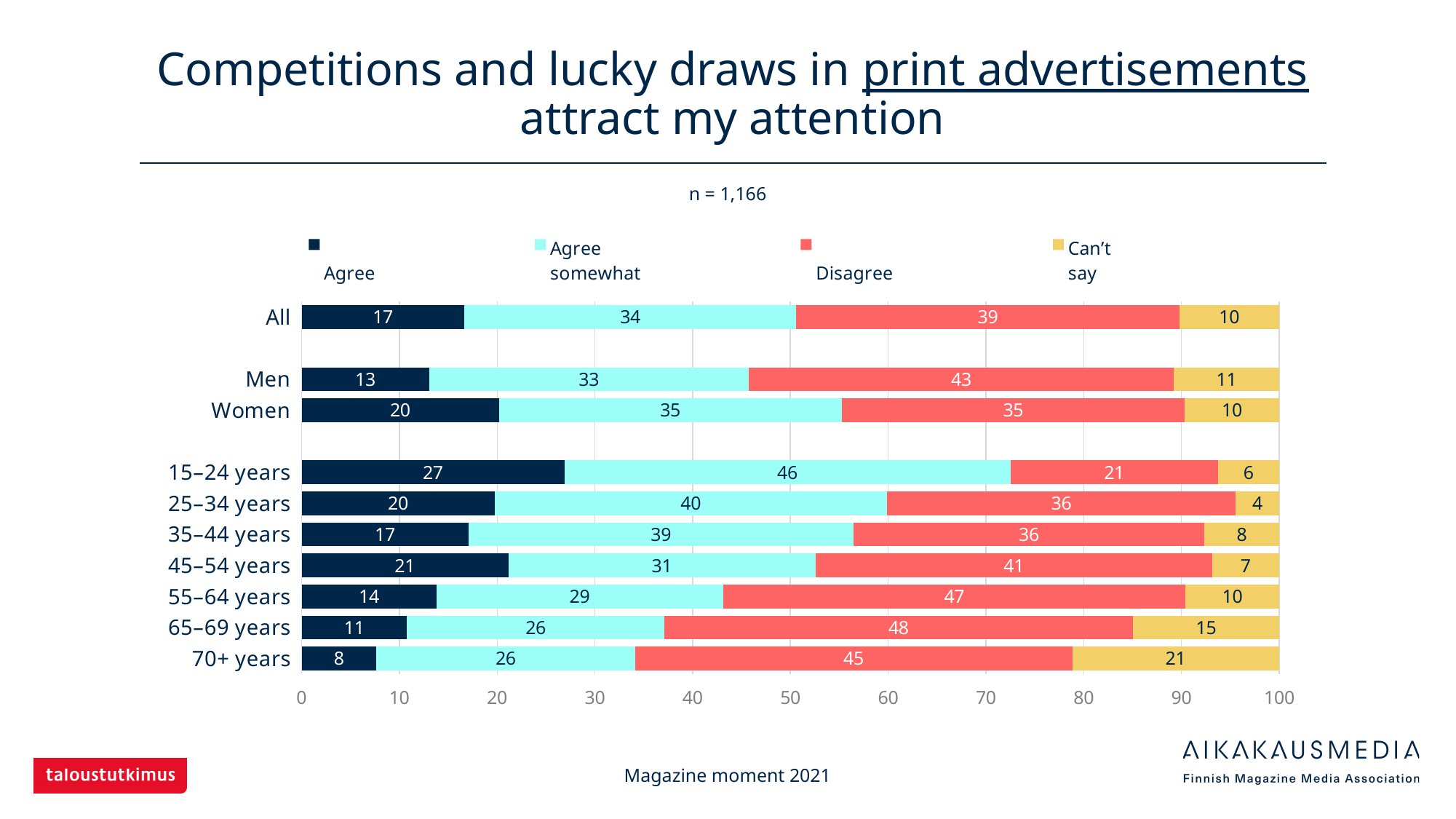
What is the value for "Agree" for Women? 20 How many series does the legend list? 4 What is the value for "Disagree" for 65–69 years? 48 What is the difference between the "Disagree" values for Men and Women? 8 What is the sample size (n) shown above the chart? n = 1,166 Which has the larger "Agree somewhat" value, 15–24 years or 25–34 years? 15–24 years Which category has the lowest "Agree" value? 70+ years What is the value for "Can't say" for 25–34 years? 4 Which category has the highest "Agree" value? 15–24 years Which category has the highest "Can't say" value? 70+ years How many categories are shown on the chart? 10 What kind of chart is shown on the slide? Stacked bar chart